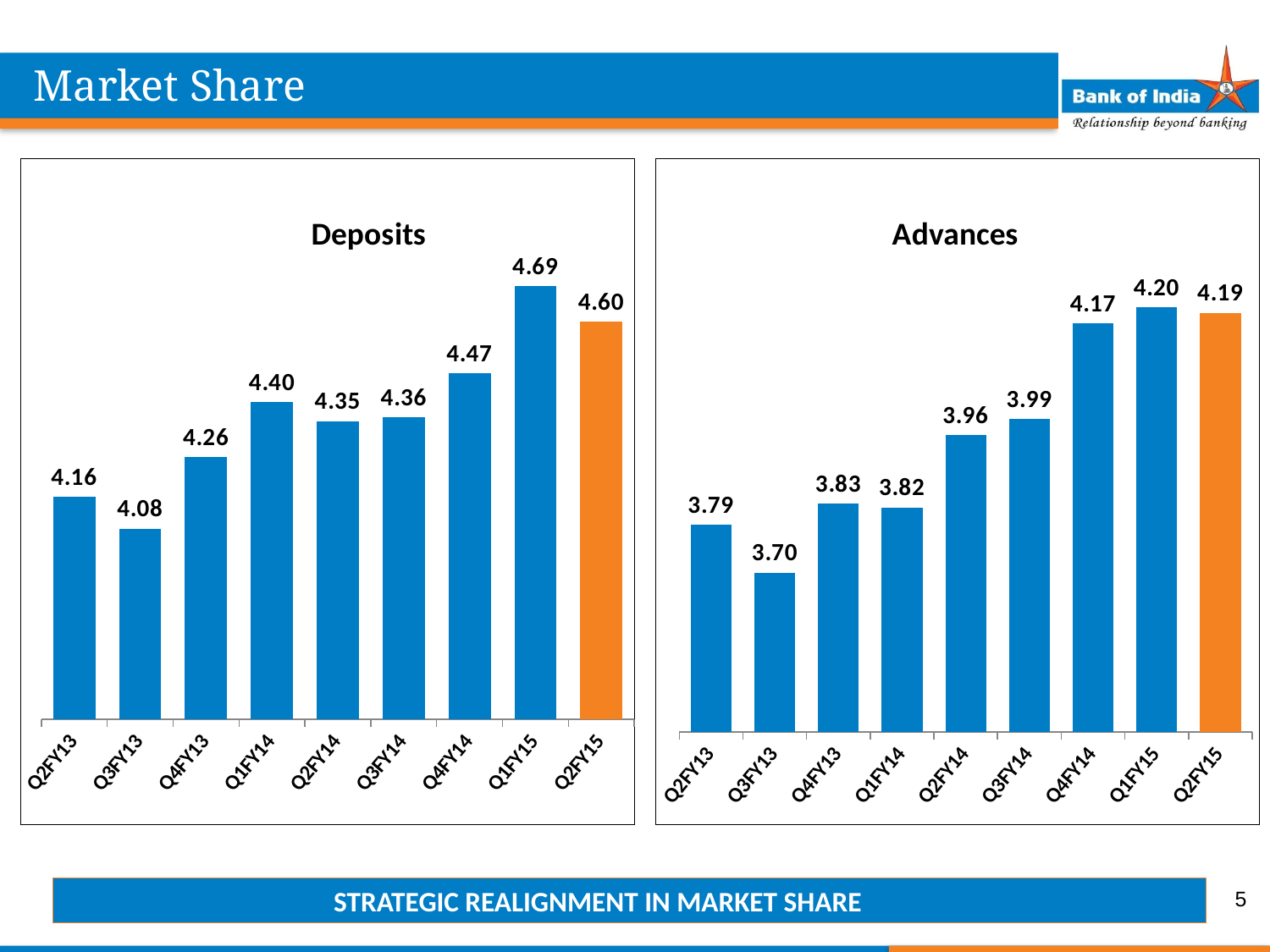
In the Deposits chart, which quarter has the lowest value? Q3FY13 In the Deposits chart, what colour is the bar for Q2FY15? Orange In the Advances chart, what is the value for Q2FY15? 4.19 In the Deposits chart, which is larger, the value for Q2FY14 or the value for Q3FY14? Q3FY14 In the Advances chart, what is the difference between the values for Q4FY14 and Q3FY14? 0.18 In the Deposits chart, what is the difference between the values for Q1FY15 and Q2FY15? 0.09 In the Advances chart, do the values generally rise or fall from Q3FY13 to Q1FY15? Rise In the Advances chart, which quarter has the highest value? Q1FY15 In the Advances chart, which is larger, the value for Q4FY13 or the value for Q1FY14? Q4FY13 How many quarters are shown in the Deposits chart? 9 In the Deposits chart, what is the value for Q1FY15? 4.69 What kind of chart is the Advances chart? Bar chart